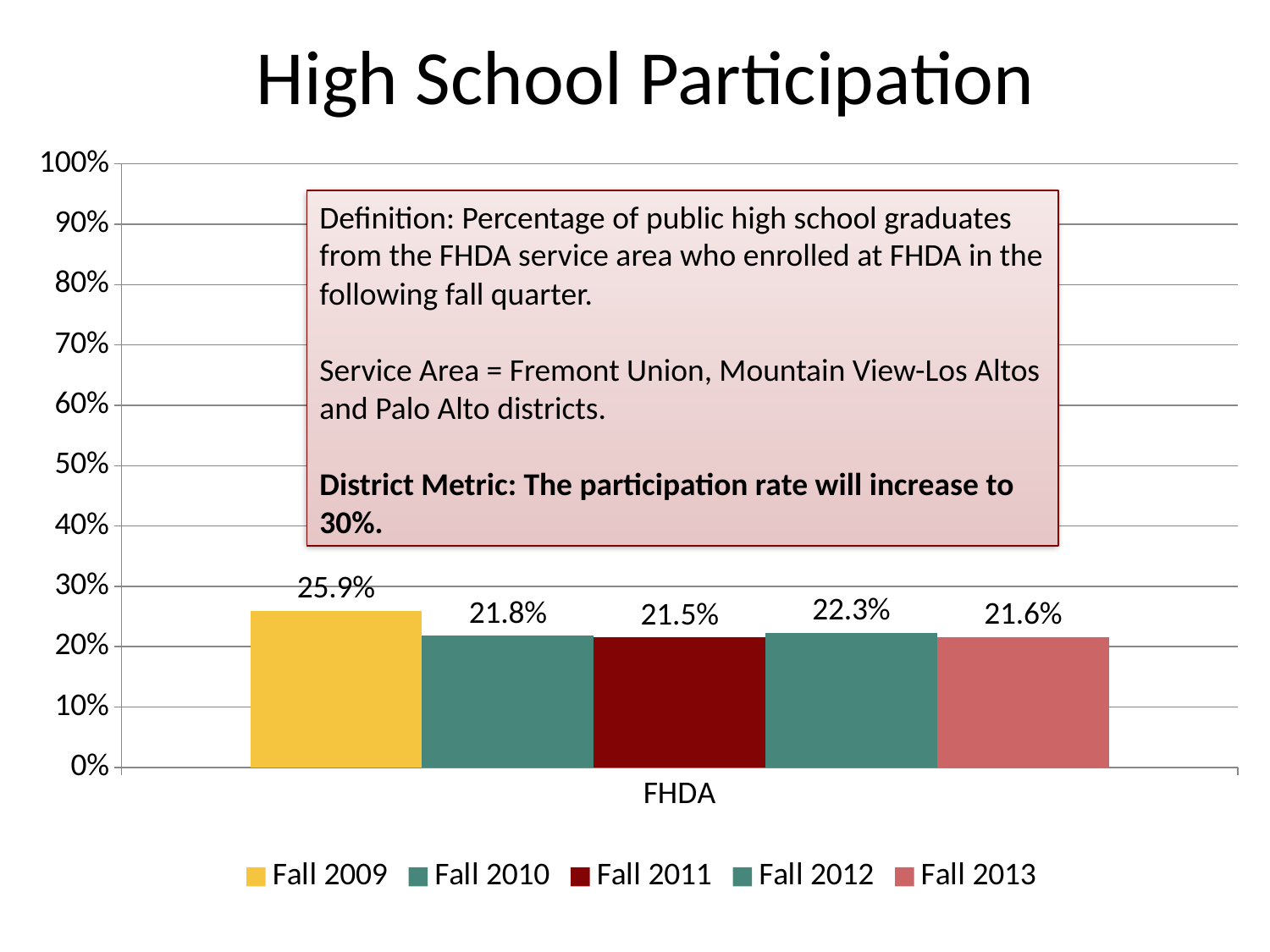
What kind of chart is shown on the slide? bar chart What is the participation rate for Fall 2012? 22.3% What is the participation rate for Fall 2009? 25.9% How many series does the legend list? 5 What is the difference between the Fall 2009 and Fall 2010 participation rates? 4.1% Which is larger, the Fall 2009 rate or the Fall 2013 rate? Fall 2009 Which series has the highest participation rate? Fall 2009 What is the participation rate for Fall 2013? 21.6% What is the title of the chart? High School Participation What is the difference between the Fall 2012 and Fall 2011 participation rates? 0.8% Is the value for Fall 2009 greater or less than 30%? less Which series has the lowest participation rate? Fall 2011